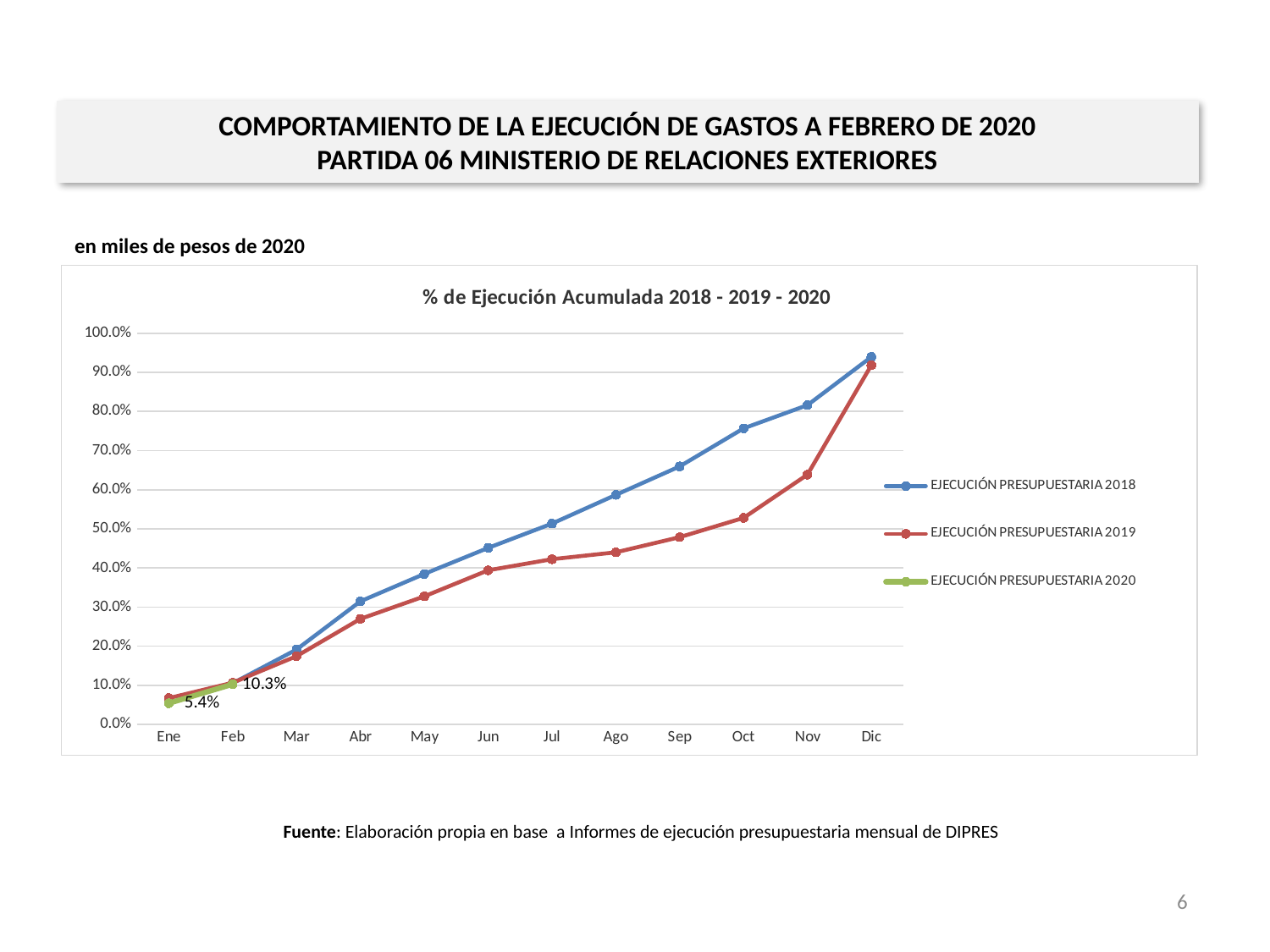
What is the value for EJECUCIÓN PRESUPUESTARIA 2020 in Ene? 5.4% What is the title of the chart? % de Ejecución Acumulada 2018 - 2019 - 2020 Do the values for EJECUCIÓN PRESUPUESTARIA 2018 rise or fall from Ene to Dic? rise What kind of chart is shown on the slide? line chart Is the value for EJECUCIÓN PRESUPUESTARIA 2018 in Dic greater or less than 90.0%? greater How many months are shown on the x axis? 12 In which month is the value for EJECUCIÓN PRESUPUESTARIA 2019 highest? Dic What is the difference between the Feb and Ene values for EJECUCIÓN PRESUPUESTARIA 2020? 4.9% What is the value for EJECUCIÓN PRESUPUESTARIA 2020 in Feb? 10.3% Is the value for EJECUCIÓN PRESUPUESTARIA 2019 in Jul greater or less than 50.0%? less How many series does the legend list? 3 In Oct, which series has the larger value, EJECUCIÓN PRESUPUESTARIA 2018 or EJECUCIÓN PRESUPUESTARIA 2019? EJECUCIÓN PRESUPUESTARIA 2018